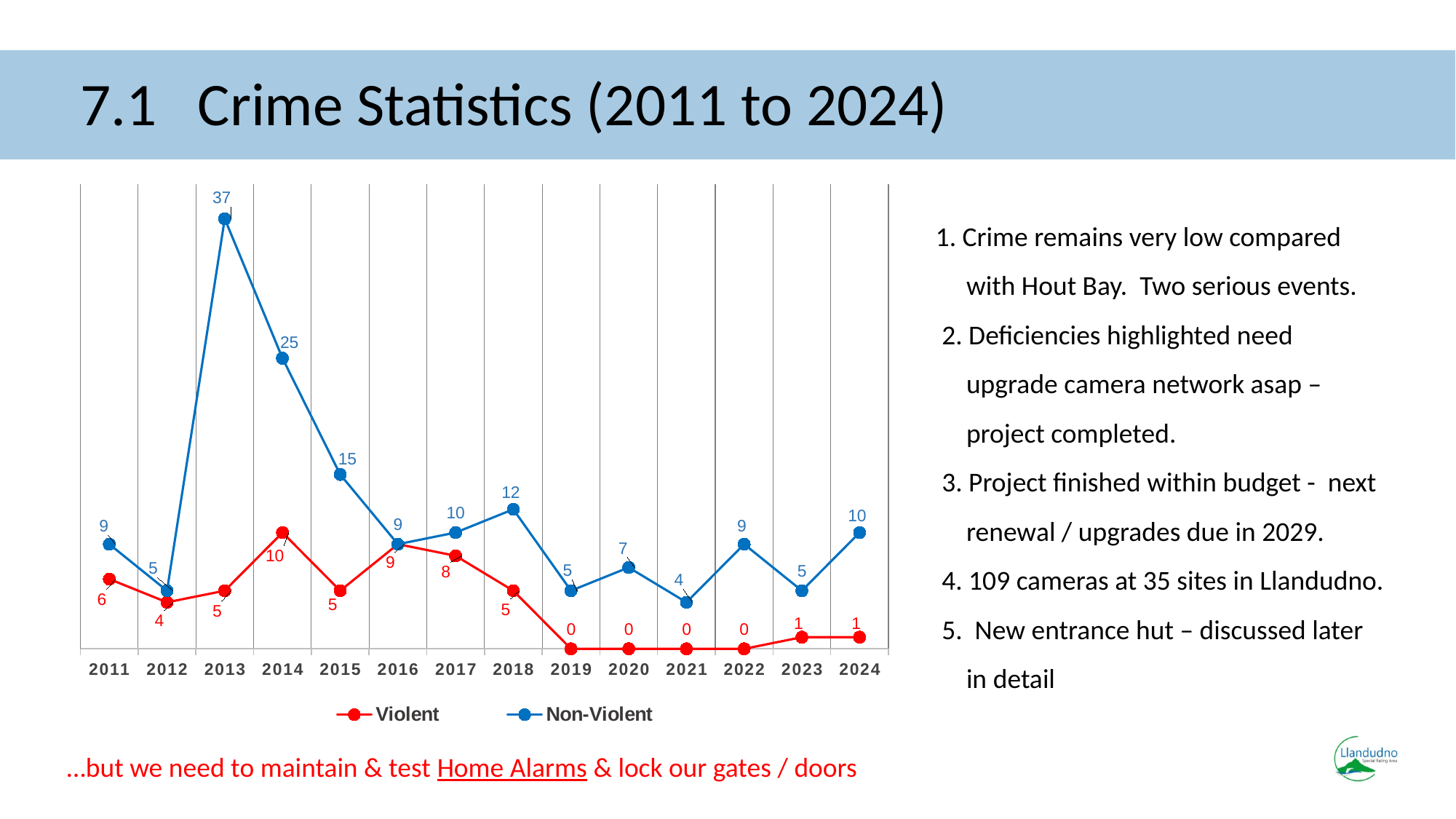
In which year is the Non-Violent value lowest? 2021 What kind of chart is shown on the slide? Line chart What is the difference between the Non-Violent and Violent values in 2014? 15 How many series does the legend list? 2 In which year does the Non-Violent series reach its highest value? 2013 Which series has the larger value in 2018, Violent or Non-Violent? Non-Violent How many years are shown on the x axis? 14 What is the Non-Violent value for 2024? 10 Does the Non-Violent series rise or fall from 2013 to 2016? Fall What is the Violent value for 2014? 10 What is the Non-Violent value for 2013? 37 What is the difference between the Non-Violent values for 2013 and 2014? 12